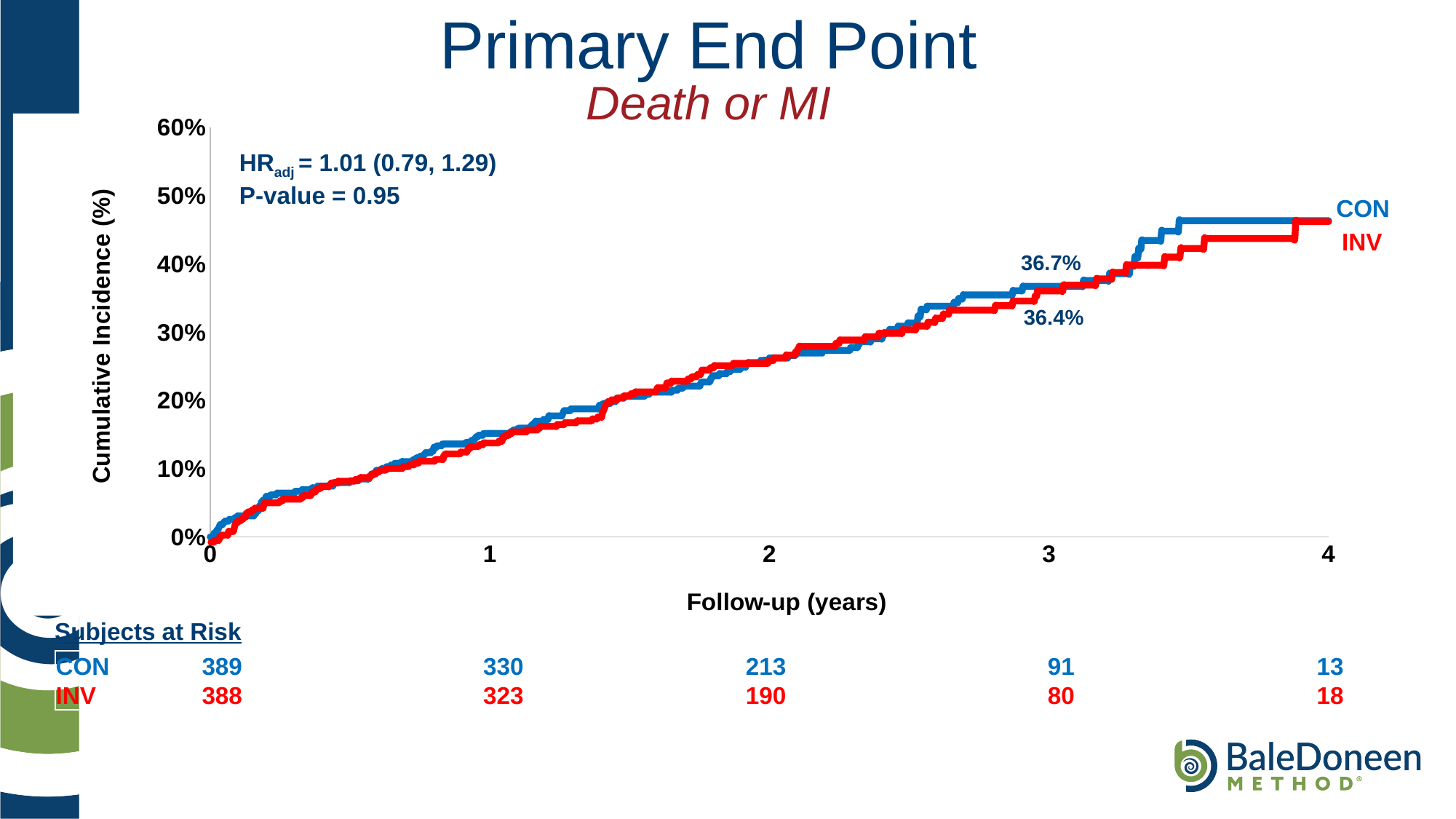
At 4 years of follow-up, is the cumulative incidence for CON greater or less than 40%? greater At 1 year of follow-up, is the cumulative incidence for INV greater or less than 20%? less What is the difference between the number of CON and INV subjects at risk at 2 years? 23 At 4 years of follow-up, which group has more subjects at risk, CON or INV? INV How many series (groups) are plotted on the chart? 2 What kind of chart is shown on the slide? line chart What P-value is reported on the chart? 0.95 What are the two cumulative incidence values labelled on the chart near 3 years of follow-up? 36.7% and 36.4% How many CON subjects were at risk at 0 years of follow-up? 389 What is the difference between the two labelled cumulative incidence values (36.7% and 36.4%)? 0.3 percentage points Does the cumulative incidence rise or fall as follow-up time increases? rise How many INV subjects were at risk at 3 years of follow-up? 80